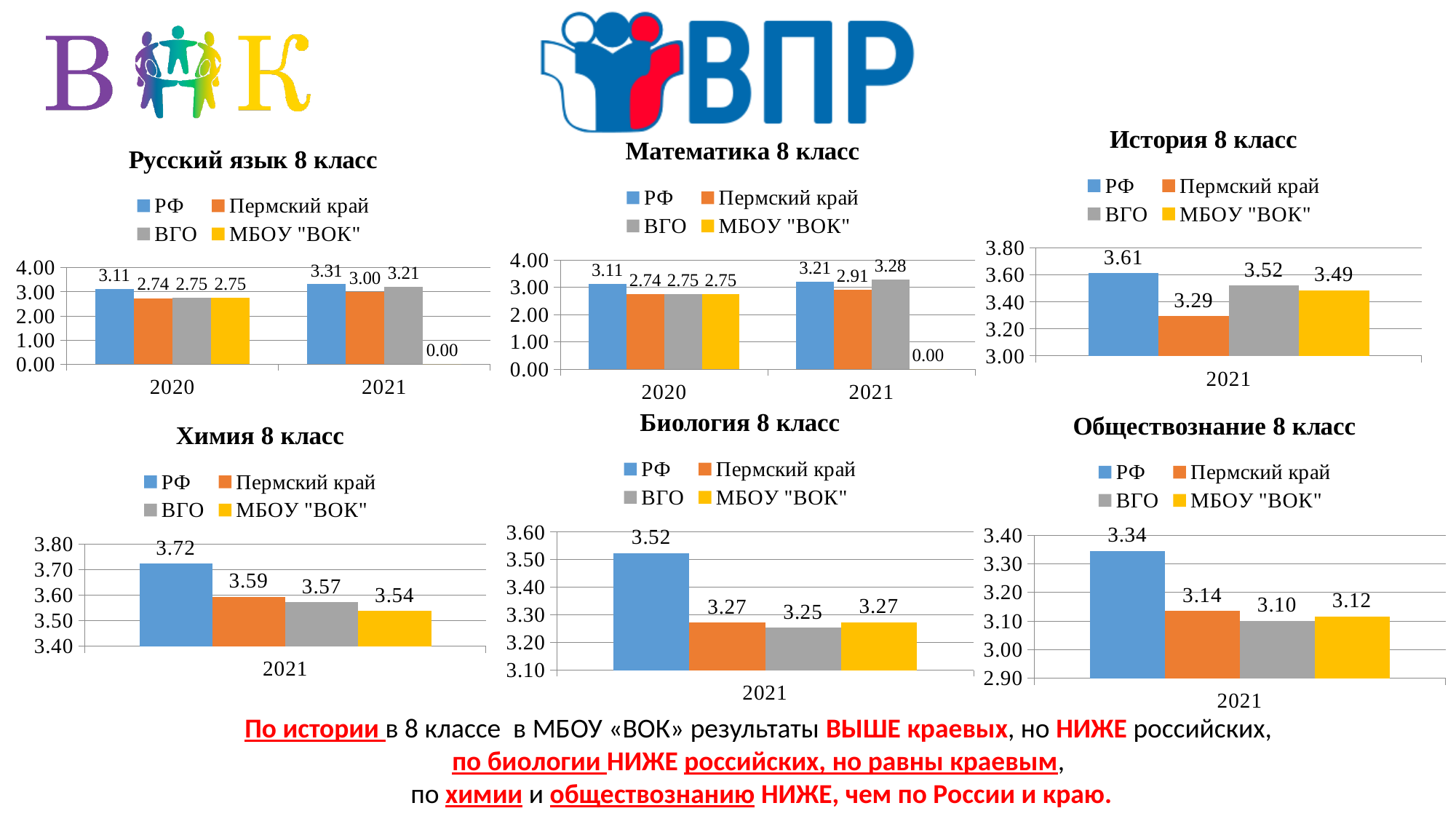
In the chart titled "Математика 8 класс", what is the value for Пермский край in 2021? 2.91 In the chart titled "Химия 8 класс", which is larger: the value for Пермский край or the value for ВГО? Пермский край In the chart titled "Химия 8 класс", what is the value for МБОУ "ВОК"? 3.54 In the chart titled "Математика 8 класс", did the value for РФ rise or fall from 2020 to 2021? rise In the chart titled "Обществознание 8 класс", which series has the lowest value? ВГО How many series does the legend of the chart titled "Биология 8 класс" list? 4 In the chart titled "Русский язык 8 класс", what is the value for ВГО in 2021? 3.21 What kind of chart is the chart titled "Обществознание 8 класс"? bar chart In the chart titled "История 8 класс", what is the difference between the values for РФ and Пермский край? 0.32 In the chart titled "История 8 класс", what is the value for РФ in 2021? 3.61 In the chart titled "Биология 8 класс", which series has the highest value? РФ In the chart titled "Русский язык 8 класс", how many years are shown on the x axis? 2